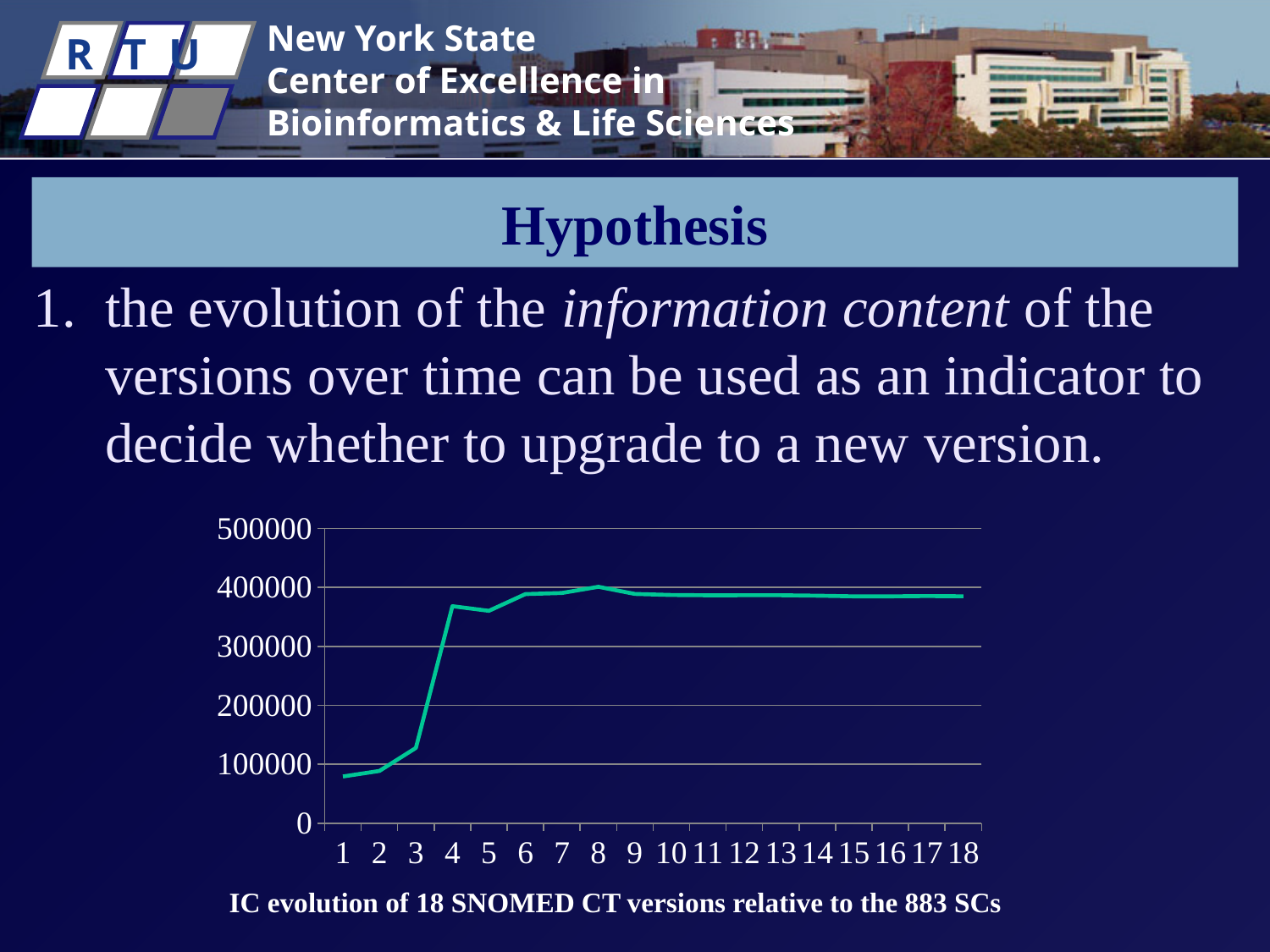
Is the value for version 12 greater or less than 500000? less Which version has the lowest information content value in the chart? 1 How many versions (points) are plotted along the x axis of the chart? 18 What is the caption printed below the chart? IC evolution of 18 SNOMED CT versions relative to the 883 SCs What kind of chart is shown on the slide? line chart Is the value for version 4 greater or less than 300000? greater Which has the larger value, version 3 or version 5? version 5 Is the value for version 1 greater or less than 100000? less Does the line generally rise or fall from version 1 to version 4? rise Which has the larger value, version 1 or version 4? version 4